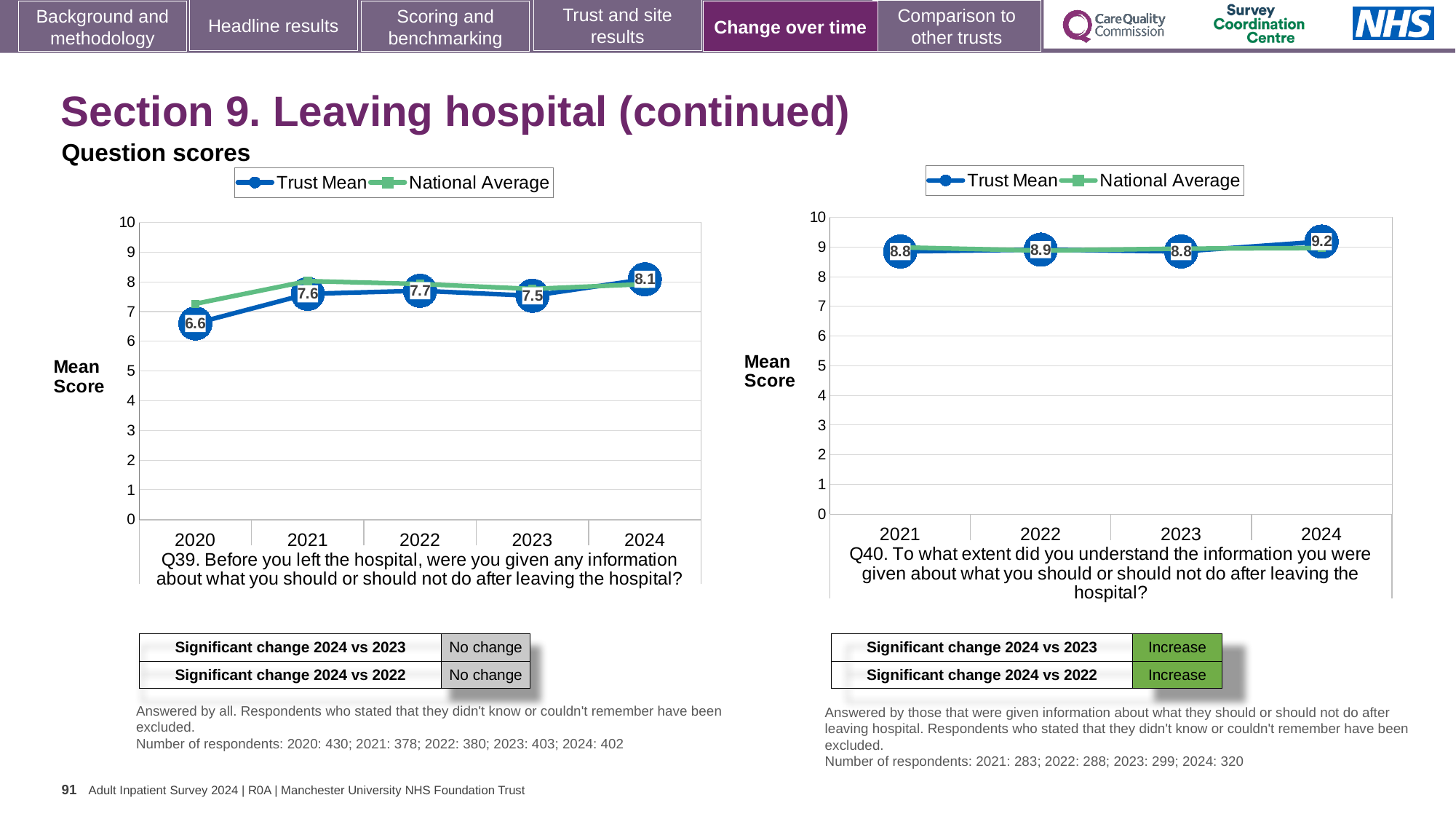
In the Q39 chart, what is the Trust Mean score for 2020? 6.6 What type of chart is used for Q39? Line chart How many series does the legend of the Q40 chart list? 2 In the Q40 chart, what is the Trust Mean score for 2024? 9.2 In the Q40 chart, is the Trust Mean score for 2021 greater or less than 8? greater In the Q39 chart, what is the Trust Mean score for 2024? 8.1 In the Q40 chart, which year has the highest Trust Mean score? 2024 In the Q40 chart, what is the Trust Mean score for 2022? 8.9 In the Q39 chart, which year has the lowest Trust Mean score? 2020 In the Q39 chart, which year has the highest Trust Mean score? 2024 In the Q39 chart, how many years are plotted on the x axis? 5 In the Q39 chart, what is the difference between the Trust Mean scores for 2024 and 2020? 1.5